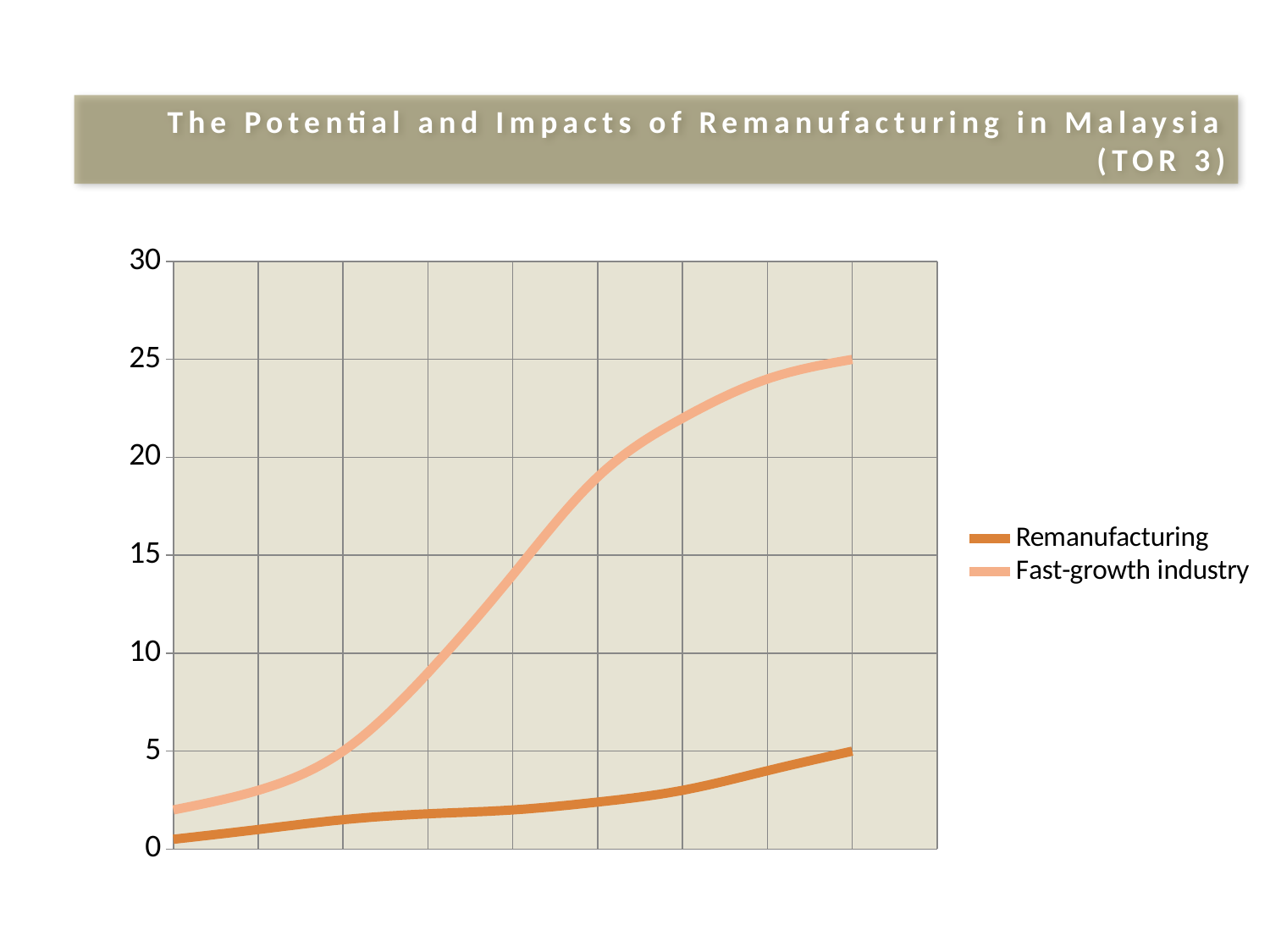
Which two series are listed in the legend? Remanufacturing and Fast-growth industry What value does the Remanufacturing line reach at its right-hand end? 5 Is the value of the Fast-growth industry line at its left-hand end greater or less than 5? less Does the Fast-growth industry line rise or fall from left to right? rise What kind of chart is shown on the slide? line chart What is the title shown at the top of the slide? The Potential and Impacts of Remanufacturing in Malaysia (TOR 3) Is the value of the Fast-growth industry line at its right-hand end greater or less than 20? greater Does the Remanufacturing line rise or fall from left to right? rise Is the highest value reached by the Remanufacturing line greater or less than 10? less What value does the Fast-growth industry line reach at its right-hand end? 25 How many series does the legend list? 2 Which series reaches the higher value at the right-hand end of the chart, Remanufacturing or Fast-growth industry? Fast-growth industry